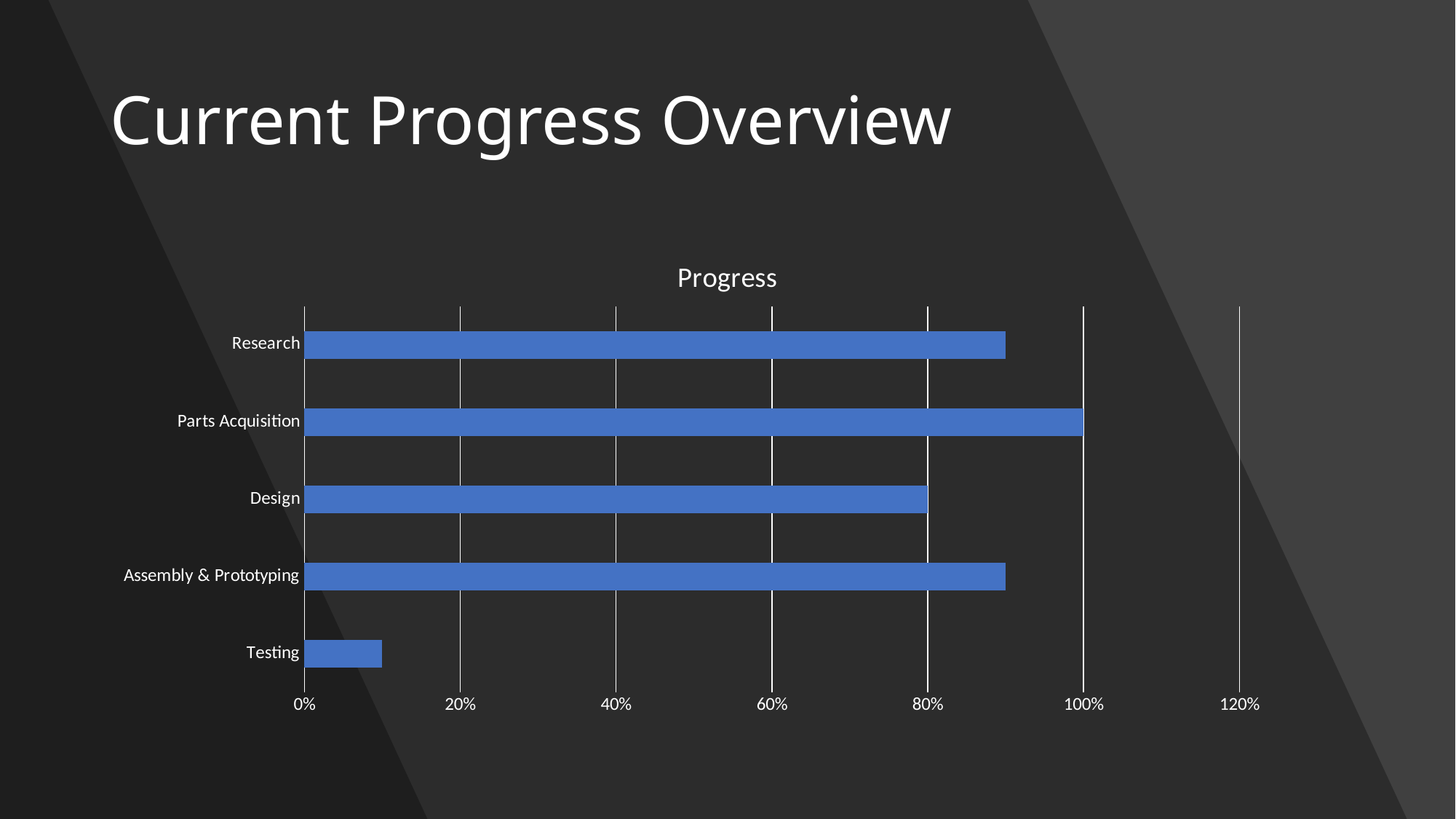
What kind of chart is shown on the slide? bar chart Which category has the lowest progress value? Testing What is the chart's title? Progress Which category has the highest progress value? Parts Acquisition What is the difference between the progress values for Parts Acquisition and Design? 20% Is the value for Assembly & Prototyping greater or less than 100%? less Is the value for Testing greater or less than 20%? less What is the progress value for Design? 80% How many categories are plotted in the chart? 5 Is the value for Research greater or less than 80%? greater What is the progress value for Parts Acquisition? 100% Which has a larger progress value, Design or Testing? Design